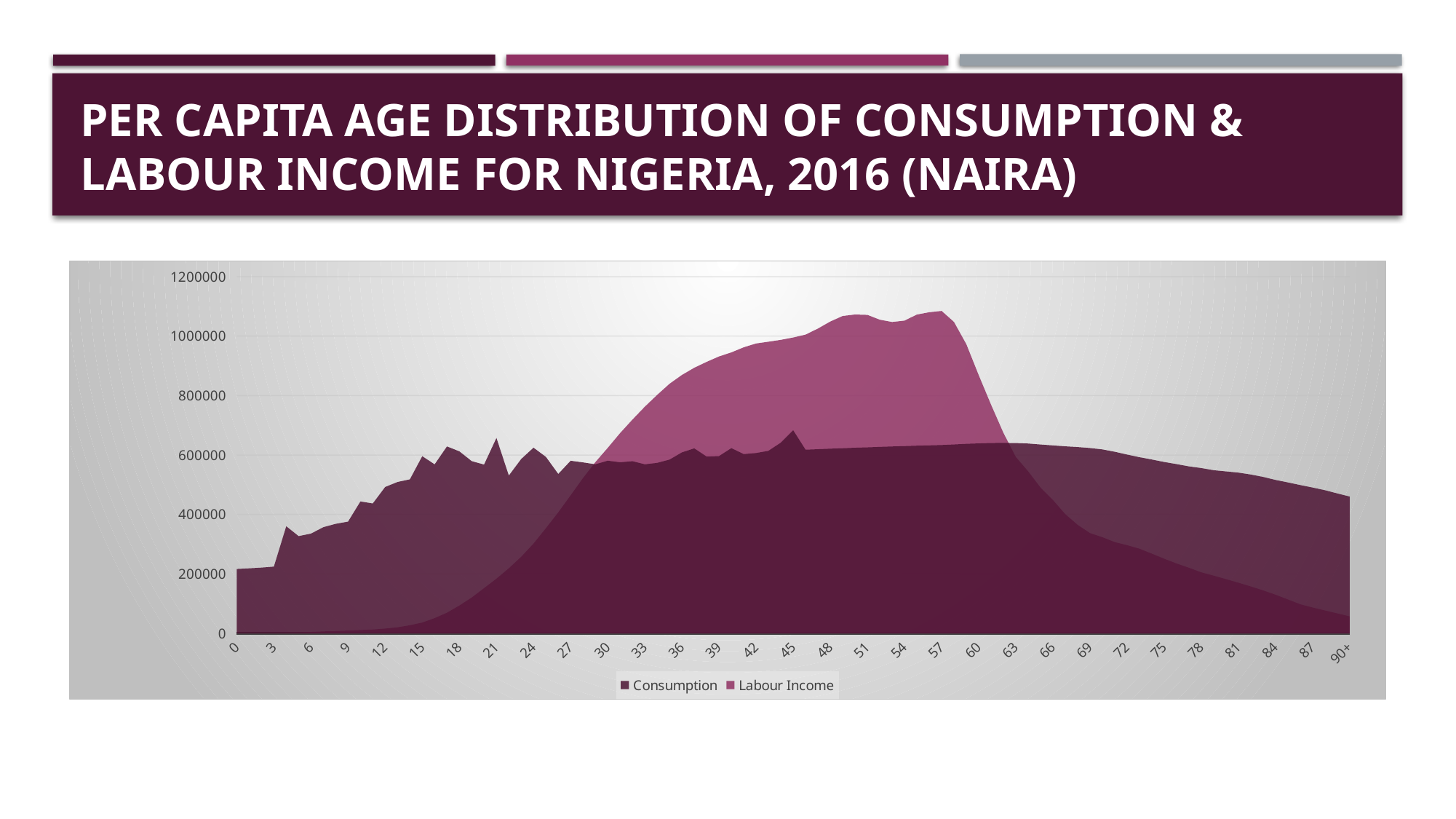
At age 54, which series has the larger value, Consumption or Labour Income? Labour Income What are the two series named in the legend? Consumption and Labour Income What is the highest value shown on the vertical axis? 1200000 What kind of chart is shown on the slide? Area chart Is the Labour Income value at age 54 greater or less than 1000000? greater Does the Labour Income series rise or fall from age 60 to age 90+? Fall Which series reaches the highest value anywhere on the chart? Labour Income Is the Labour Income value at age 0 greater or less than 200000? less Is the Consumption value at age 90+ greater or less than 400000? greater How many series does the legend list? 2 At age 12, which series has the larger value, Consumption or Labour Income? Consumption